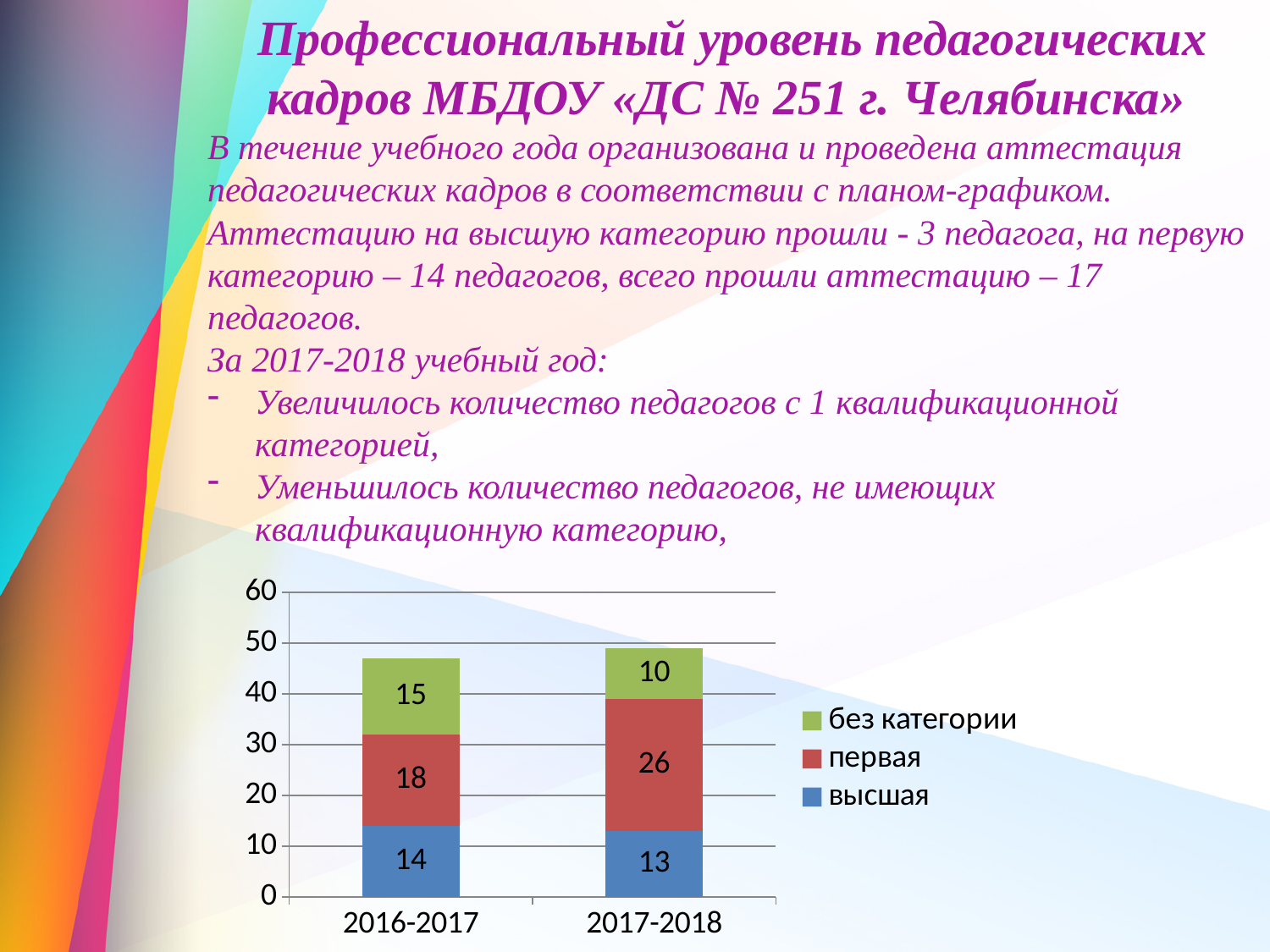
What is the total of the stacked bar for 2016-2017? 47 What is the total of the stacked bar for 2017-2018? 49 What is the value for "первая" in 2017-2018? 26 What is the value for "высшая" in 2017-2018? 13 What kind of chart is shown on the slide? stacked bar chart What is the value for "без категории" in 2016-2017? 15 Which is larger: "без категории" in 2016-2017 or in 2017-2018? 2016-2017 How many series does the legend list? 3 Which colour represents "высшая" in the chart? blue How many categories are shown on the x axis? 2 Which year has the higher value for "первая"? 2017-2018 What is the difference between the "первая" values for 2017-2018 and 2016-2017? 8